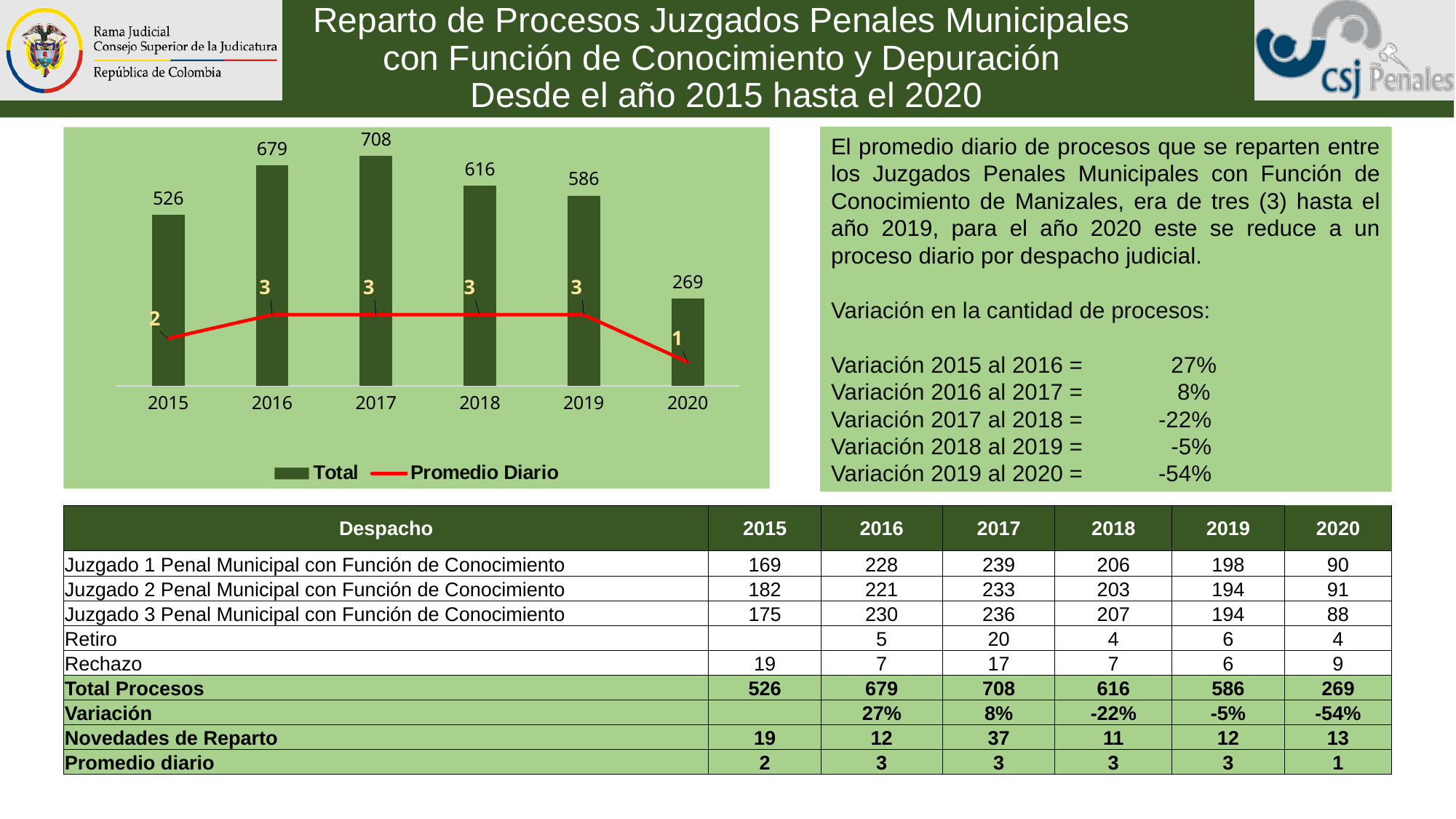
Which year has the lowest Total in the chart? 2020 What is the Total value for 2017 in the chart? 708 Does the Total series rise or fall from 2017 to 2020 in the chart? Fall What colour is the Promedio Diario line in the chart? Red How many series does the chart legend list? 2 Which is larger in the chart, the Total for 2016 or the Total for 2018? 2016 Which year has the highest Total in the chart? 2017 What is the difference between the Total for 2019 and the Total for 2020 in the chart? 317 What kind of chart is shown on the slide? Combined bar and line chart How many years are shown on the x axis of the chart? 6 What is the Promedio Diario value for 2020 in the chart? 1 What is the Promedio Diario value for 2015 in the chart? 2